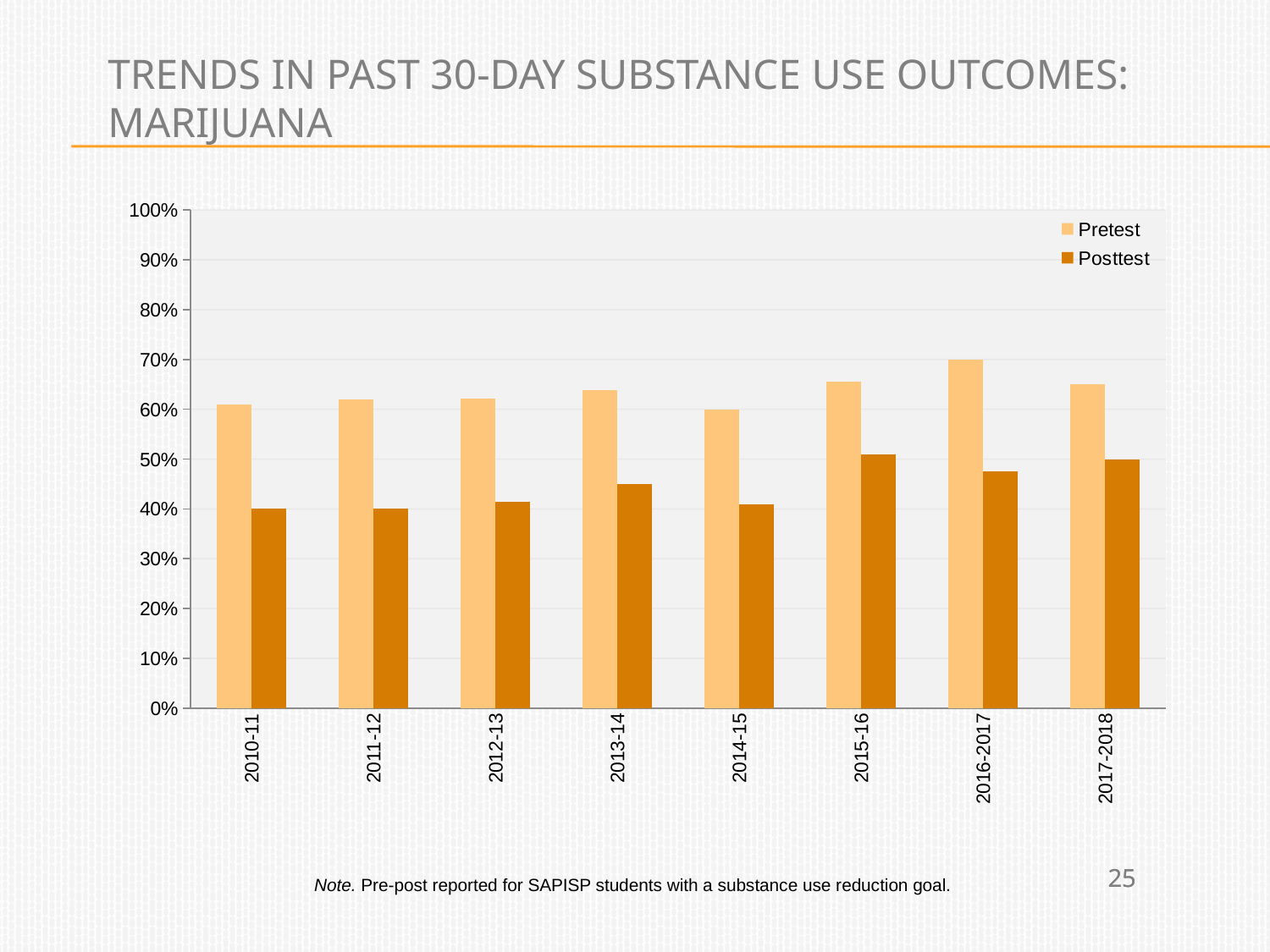
Which is larger, the Posttest value for 2013-14 or the Posttest value for 2010-11? 2013-14 Is the Posttest value for 2013-14 greater or less than 50%? less Which school year has the highest Pretest value? 2016-2017 Is the Pretest value for 2016-2017 greater or less than 60%? greater In 2015-16, which is larger, the Pretest value or the Posttest value? Pretest Is the Pretest value for 2014-15 greater or less than 50%? greater What kind of chart is shown on the slide? Bar chart How many school-year categories are shown on the x axis? 8 How many series does the legend list? 2 Do the Pretest values rise or fall from 2014-15 to 2016-2017? rise What are the two series named in the legend? Pretest and Posttest